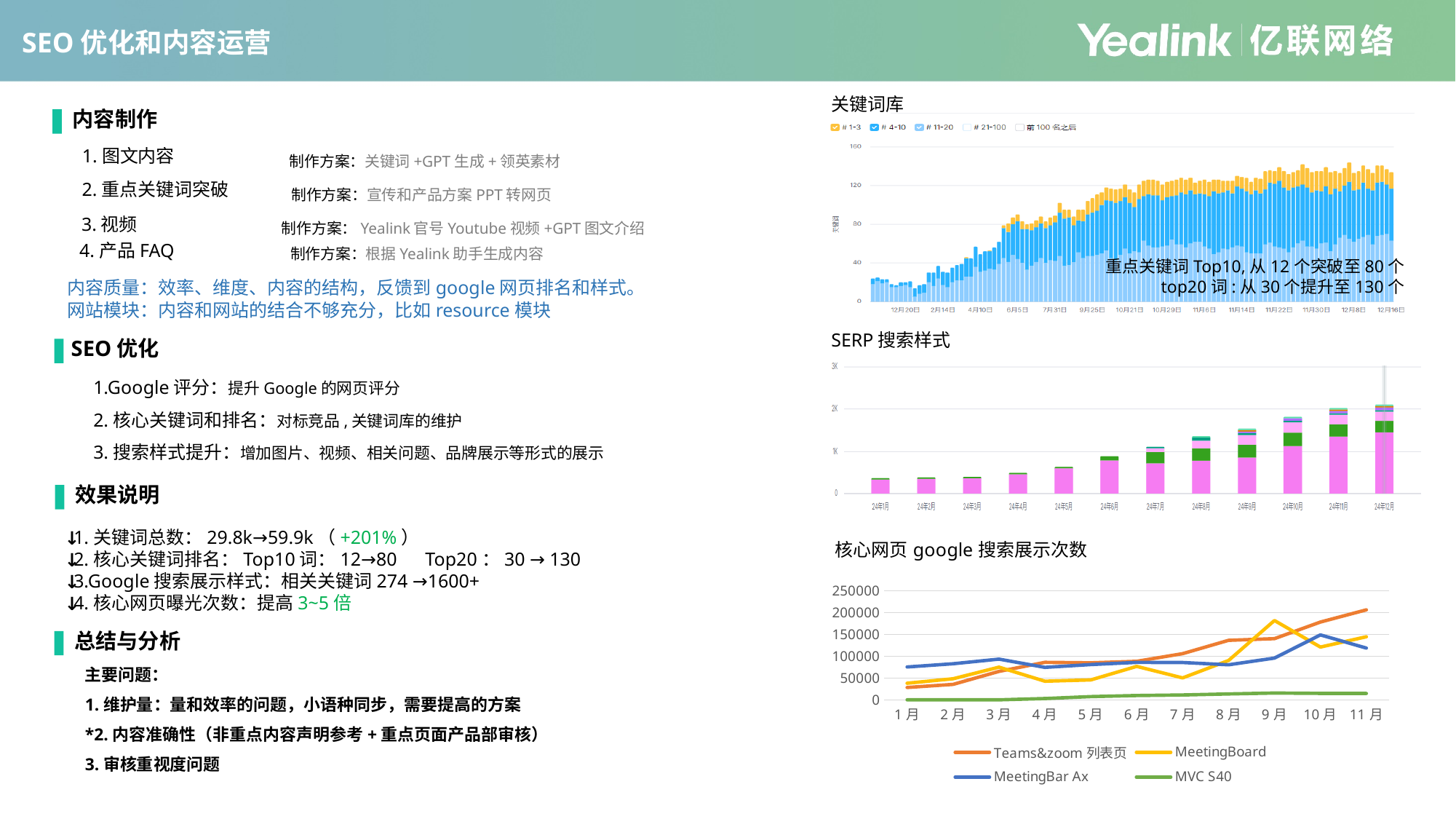
In the '核心网页 google 搜索展示次数' chart, is the value for Teams&zoom 列表页 at 11 月 greater or less than 150000? greater In the '核心网页 google 搜索展示次数' chart, is the value for MVC S40 at 11 月 greater or less than 50000? less In the '核心网页 google 搜索展示次数' chart, which series has the highest value at 11 月? Teams&zoom 列表页 What kind of chart is the 'SERP 搜索样式' chart? bar chart How many entries does the legend of the '关键词库' chart list? 5 How many series does the legend of the '核心网页 google 搜索展示次数' chart list? 4 In the '核心网页 google 搜索展示次数' chart, which series has the lowest value at 11 月? MVC S40 In the '核心网页 google 搜索展示次数' chart, which is larger at 9 月: MeetingBoard or MeetingBar Ax? MeetingBoard What kind of chart is the '核心网页 google 搜索展示次数' chart? line chart How many months are shown on the x axis of the '核心网页 google 搜索展示次数' chart? 11 In the '核心网页 google 搜索展示次数' chart, does the Teams&zoom 列表页 series generally rise or fall from 1 月 to 11 月? rise How many months are shown on the x axis of the 'SERP 搜索样式' chart? 12